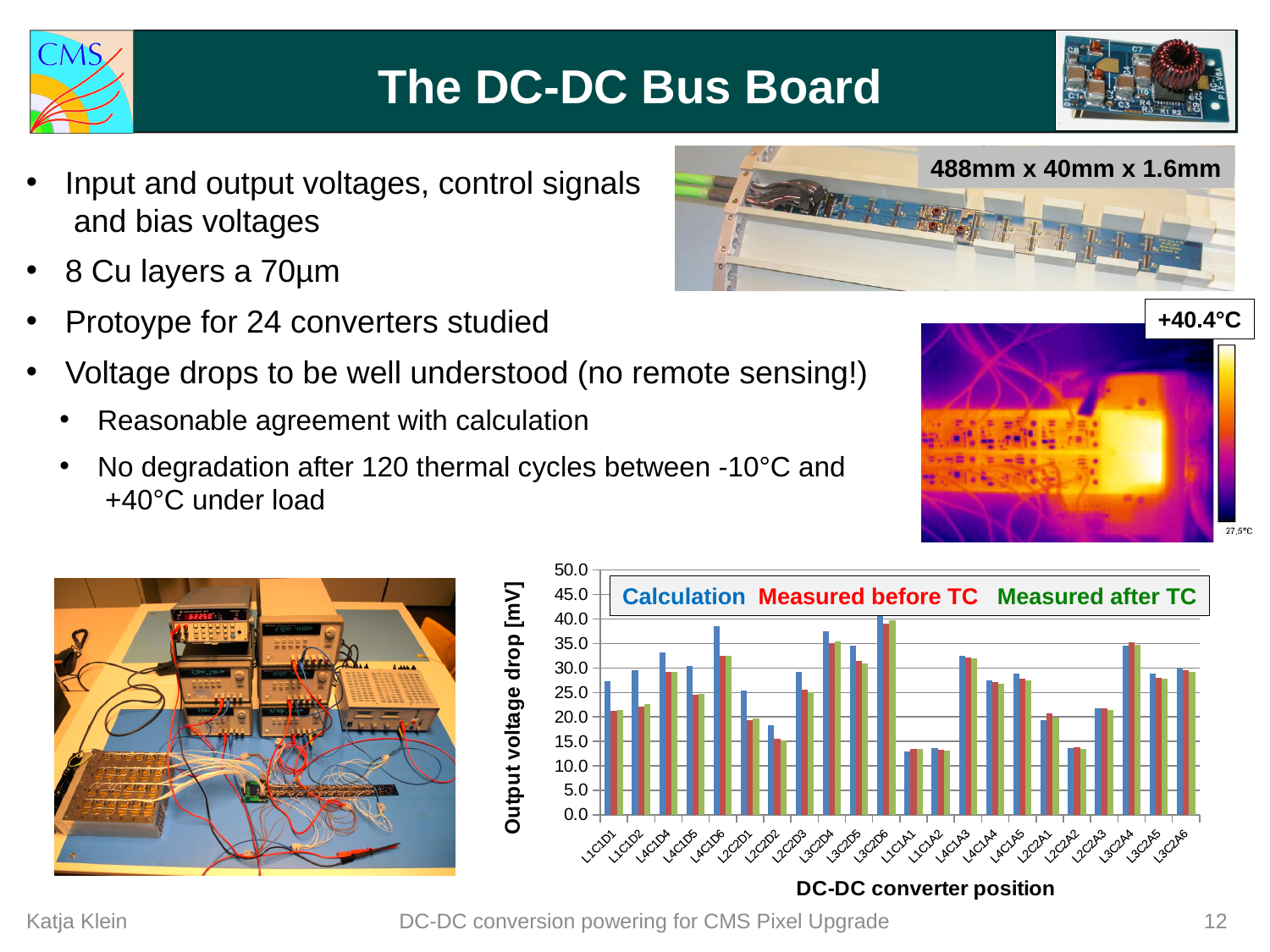
How many DC-DC converter positions are shown on the x axis of the output voltage drop chart? 22 What is the y-axis label of the output voltage drop chart? Output voltage drop [mV] In the output voltage drop chart, at which converter position is the Measured before TC value highest? L3C2D6 In the output voltage drop chart, at which converter position is the Calculation value highest? L3C2D6 In the output voltage drop chart, is the Calculation value for L4C1D6 greater or less than 35.0? greater How many series does the legend of the output voltage drop chart list? 3 What kind of chart is shown at the bottom right of the slide? bar chart In the output voltage drop chart, which is larger at L4C1D6: the Calculation value or the Measured before TC value? Calculation In the output voltage drop chart, is the Calculation value for L3C2D6 greater or less than 35.0? greater In the output voltage drop chart, is the Calculation value for L1C1A1 greater or less than 15.0? less What is the x-axis label of the output voltage drop chart? DC-DC converter position